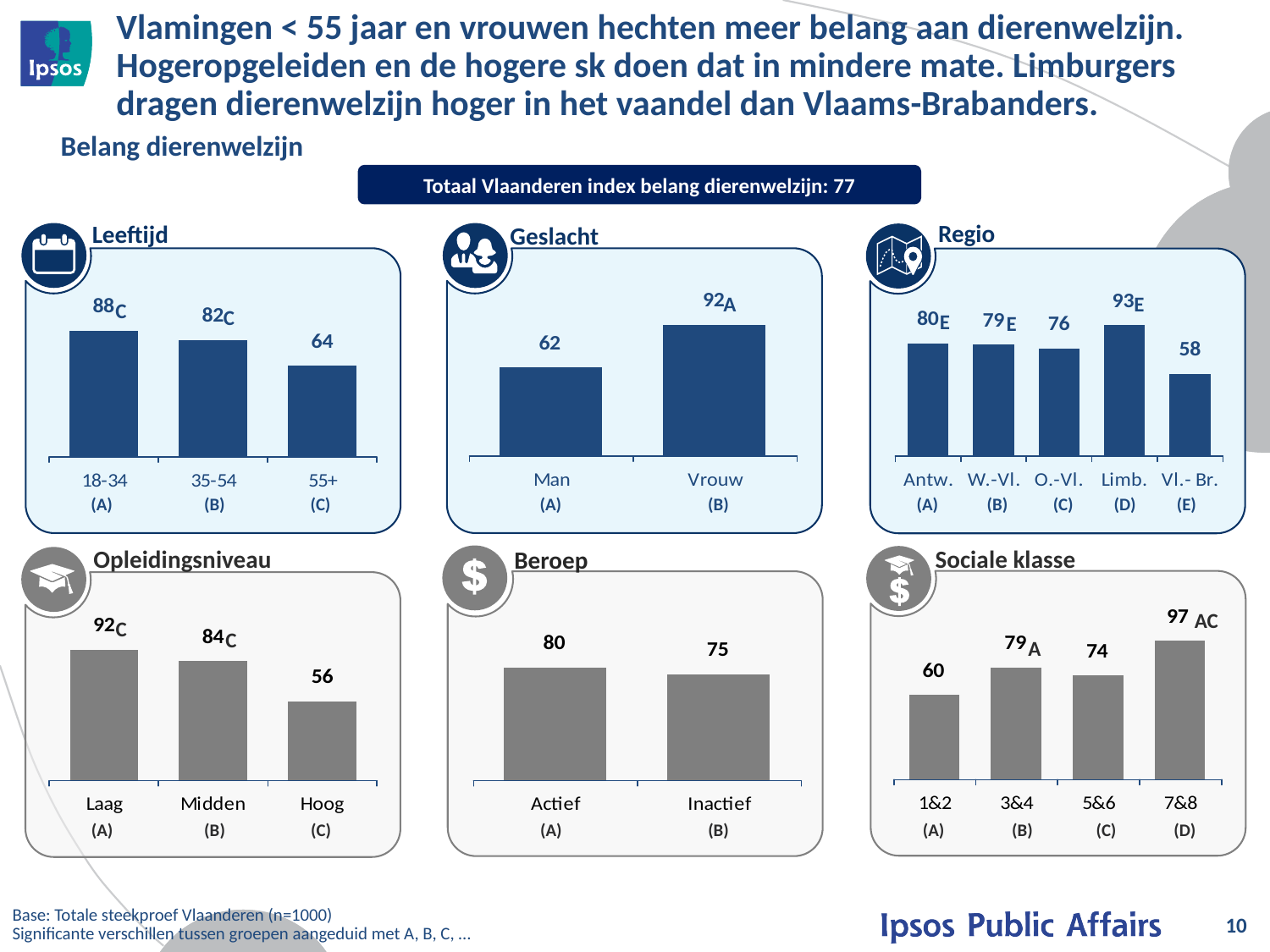
In the Beroep chart, which is larger, the value for Actief or for Inactief? Actief How many categories are shown in the Regio chart? 5 In the Sociale klasse chart, what is the difference between the values for 7&8 and 1&2? 37 In the Regio chart, which region has the lowest value? Vl.- Br. In the Regio chart, which region has the highest value? Limb. In the Sociale klasse chart, what is the value for 7&8? 97 In the Leeftijd chart, what is the value for the 18-34 group? 88 What kind of chart is the Leeftijd chart? bar chart What is the total Vlaanderen index for belang dierenwelzijn shown on the slide? 77 In the Leeftijd chart, do the values rise or fall from 18-34 to 55+? fall In the Opleidingsniveau chart, what is the difference between the values for Laag and Hoog? 36 In the Geslacht chart, what is the value for Vrouw? 92